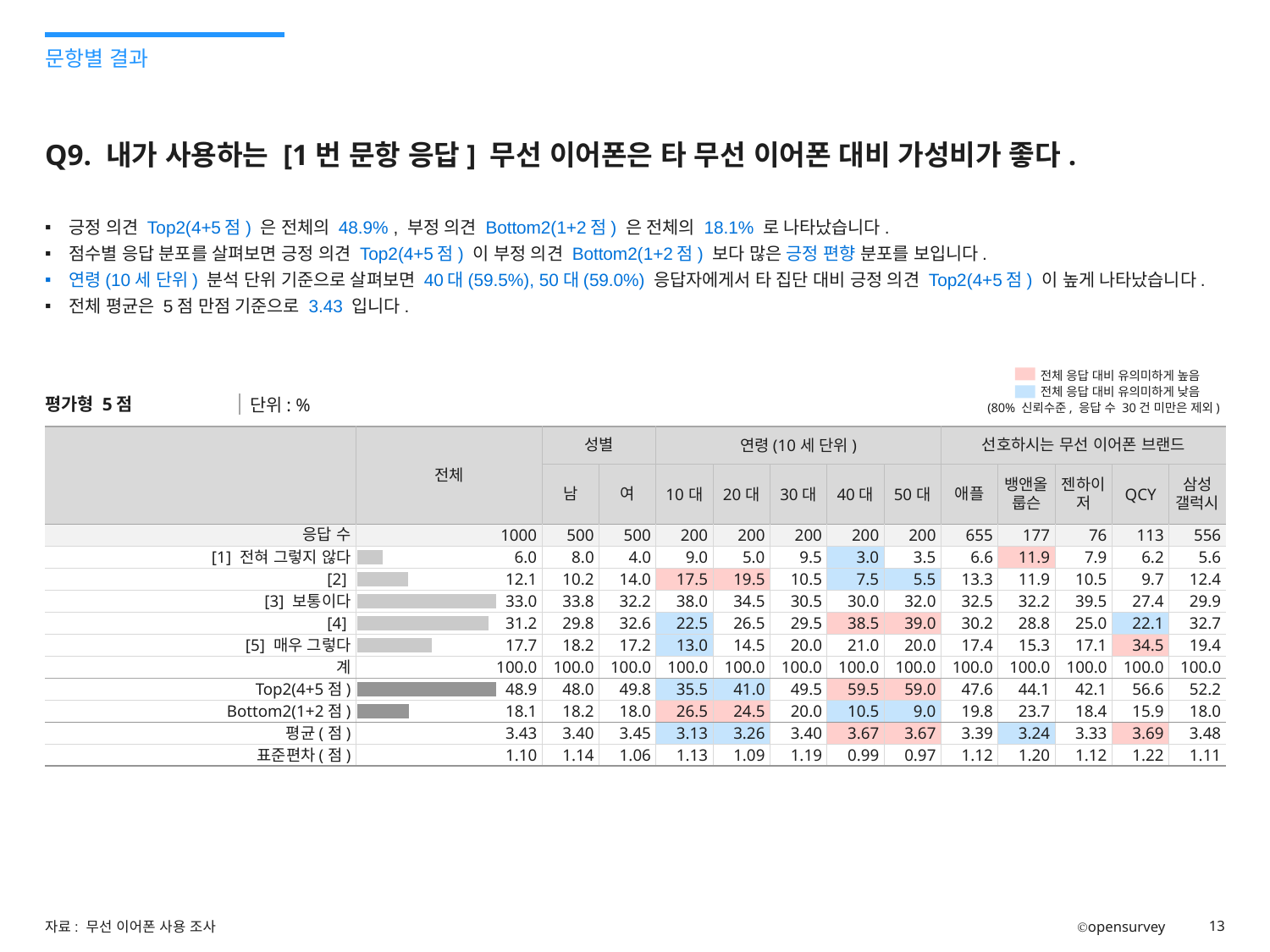
What kind of chart is shown in the 전체 column of the table? bar chart What is the Top2(4+5점) value for 40대? 59.5 How many score categories ([1] through [5]) are plotted as bars? 5 What is the 전체 응답 수? 1000 Which has a larger 전체 value, [4] or [5] 매우 그렇다? [4] Among the five score categories [1] to [5], which has the lowest 전체 value? [1] 전혀 그렇지 않다 What is the 전체 value for [3] 보통이다 in the bar chart? 33.0 What is the difference between the 전체 values for Top2(4+5점) and Bottom2(1+2점)? 30.8 What is the 전체 평균(점) value? 3.43 What is the difference between the 전체 values for [3] 보통이다 and [4]? 1.8 What unit is stated for the values in the table? % Among the five score categories [1] to [5], which has the highest 전체 value? [3] 보통이다